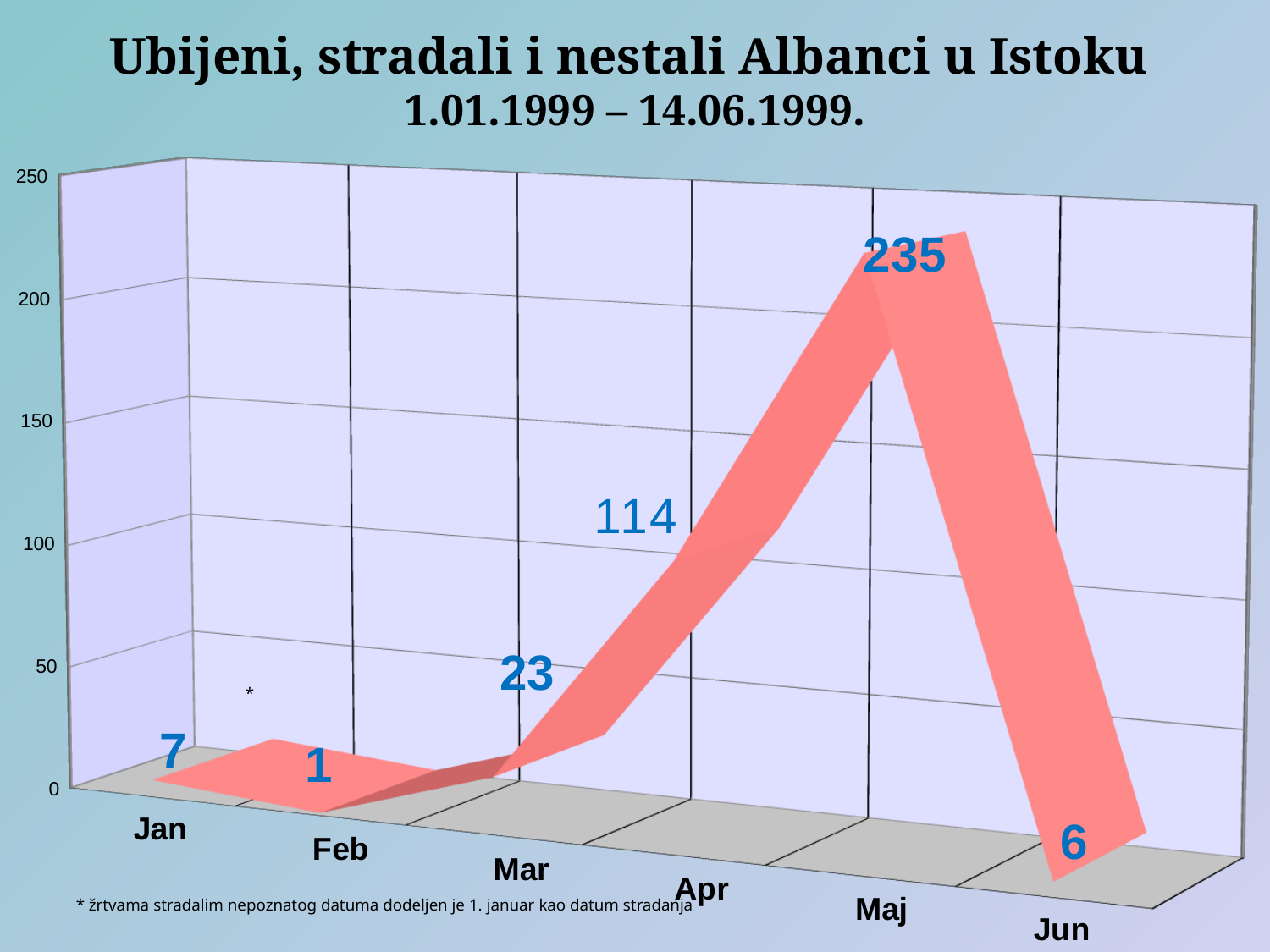
What is the value for Apr? 114 What is the value for Maj? 235 What kind of chart is shown on the slide? 3D line chart Which is larger, the value for Mar or the value for Jun? Mar Which month has the lowest value? Feb How many months are shown on the x axis? 6 What is the value for Mar? 23 What is the difference between the values for Maj and Apr? 121 Is the value for Maj greater or less than 200? greater What is the date range given in the chart title? 1.01.1999 – 14.06.1999. Which month has the highest value? Maj What is the value for Jan? 7